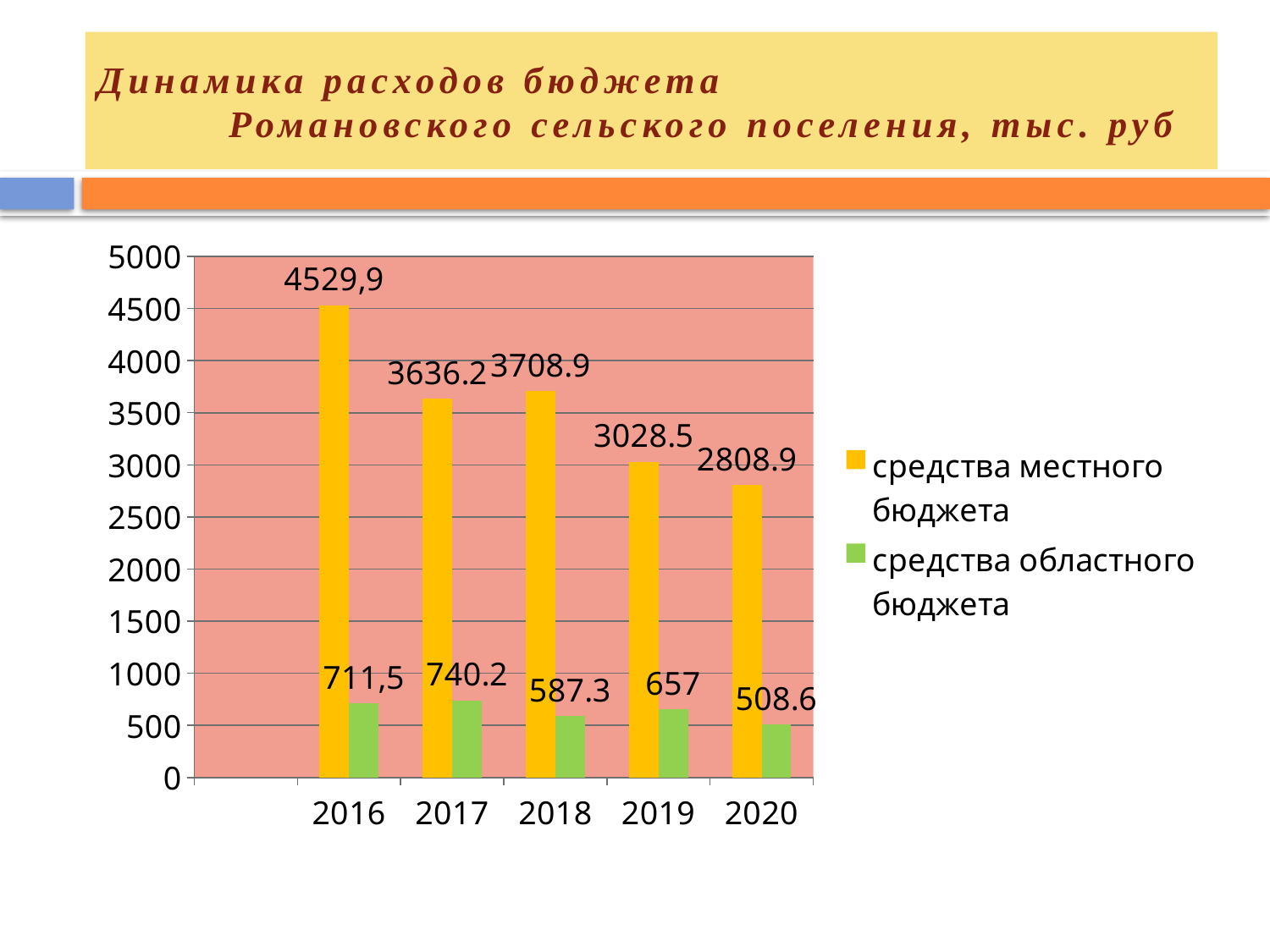
How many series does the legend list? 2 What is the value for средства местного бюджета in 2016? 4529,9 What kind of chart is shown on the slide? bar chart What is the value for средства местного бюджета in 2020? 2808.9 Which is larger: средства местного бюджета in 2018 or in 2019? 2018 Which colour represents средства областного бюджета in the legend? green In which year is средства местного бюджета highest? 2016 What is the difference between средства местного бюджета in 2016 and in 2020? 1721 How many years are shown on the x axis? 5 Is the value for средства местного бюджета in 2018 greater or less than 3500? greater In which year is средства областного бюджета lowest? 2020 What is the value for средства областного бюджета in 2019? 657